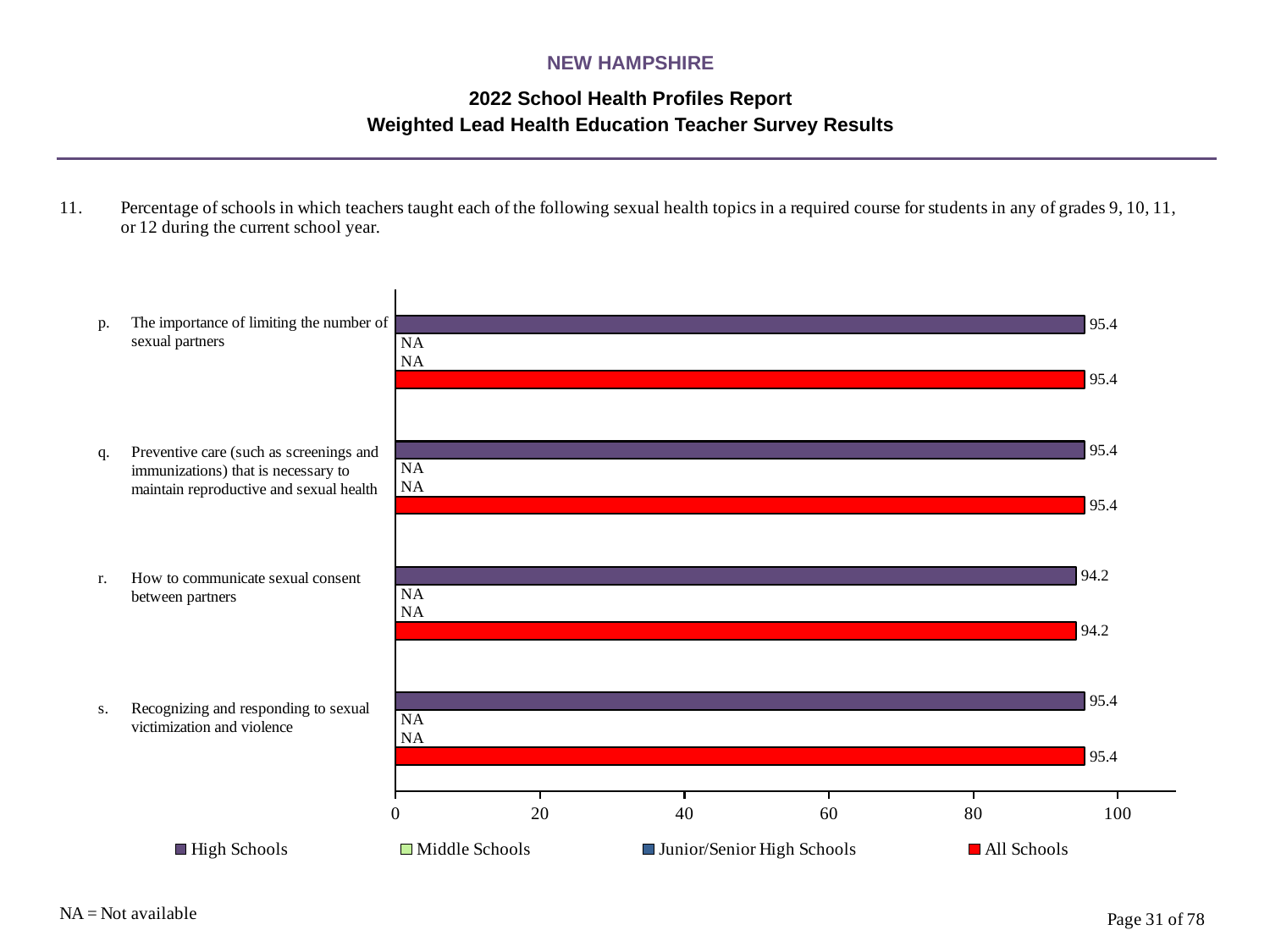
Is the High Schools value for 'Recognizing and responding to sexual victimization and violence' greater or less than 80? greater What is shown for Middle Schools for 'Preventive care (such as screenings and immunizations) that is necessary to maintain reproductive and sexual health'? NA What is the value for All Schools for 'Recognizing and responding to sexual victimization and violence'? 95.4 Which is larger: the All Schools value for 'Preventive care' or the All Schools value for 'How to communicate sexual consent between partners'? Preventive care What is the value for High Schools for 'How to communicate sexual consent between partners'? 94.2 What is the difference between the High Schools values for 'The importance of limiting the number of sexual partners' and 'How to communicate sexual consent between partners'? 1.2 Which topic has the lowest High Schools value? How to communicate sexual consent between partners How many series does the legend list? 4 Which series is shown in red in the legend? All Schools What kind of chart is shown on the slide? bar chart How many topics (categories) are shown on the chart? 4 What is the value for High Schools for 'The importance of limiting the number of sexual partners'? 95.4